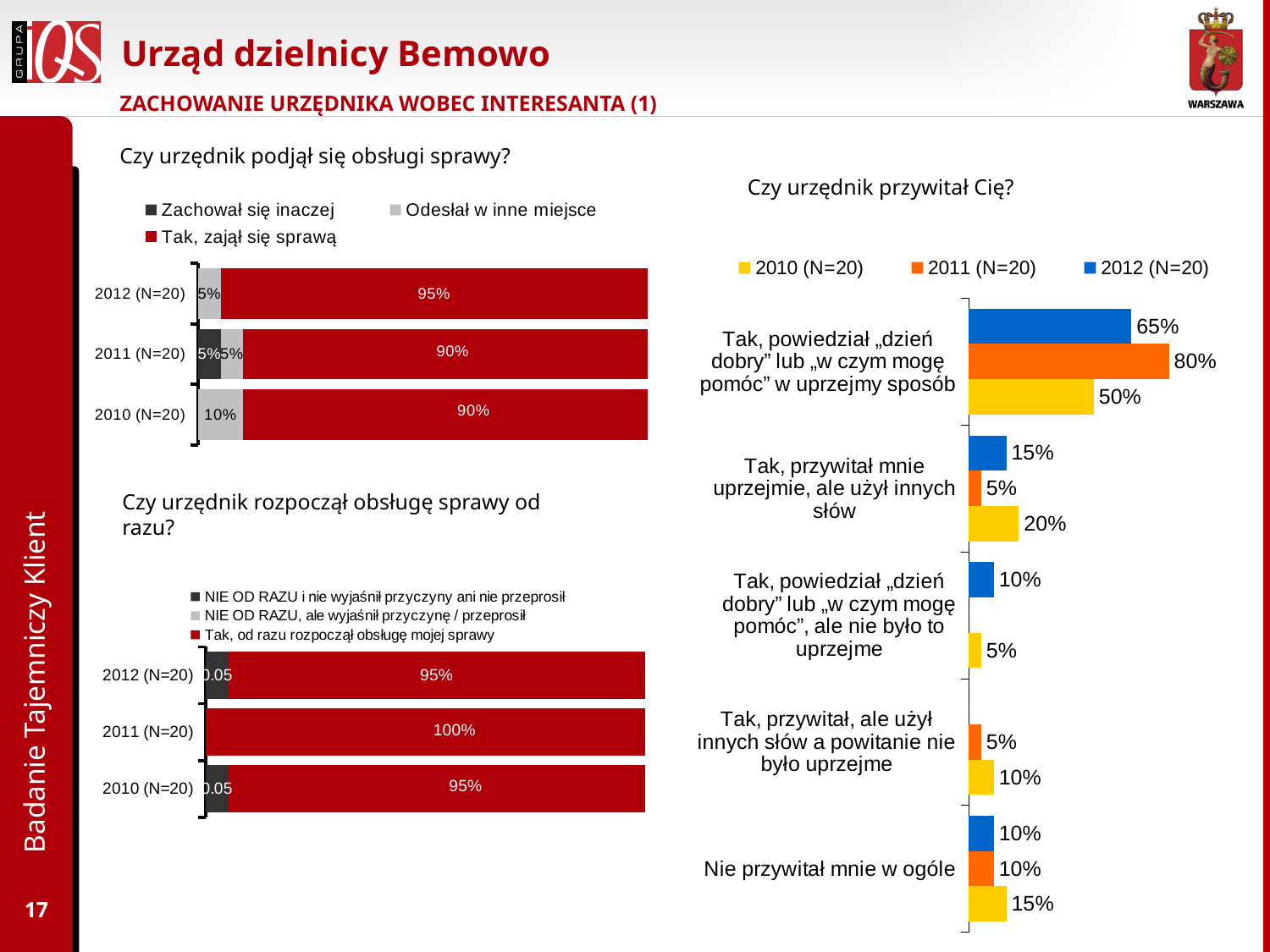
In the chart "Czy urzędnik przywitał Cię?", which year has the highest value for "Tak, powiedział „dzień dobry” lub „w czym mogę pomóc” w uprzejmy sposób"? 2011 (N=20) In the chart "Czy urzędnik podjął się obsługi sprawy?", what is the "Tak, zajął się sprawą" value for 2012 (N=20)? 95% In the chart "Czy urzędnik przywitał Cię?", how many series does the legend list? 3 In the chart "Czy urzędnik podjął się obsługi sprawy?", what is the "Odesłał w inne miejsce" value for 2010 (N=20)? 10% In the chart "Czy urzędnik przywitał Cię?", what is the 2010 (N=20) value for "Nie przywitał mnie w ogóle"? 15% In the chart "Czy urzędnik przywitał Cię?", which is larger for "Tak, przywitał mnie uprzejmie, ale użył innych słów": the 2010 value or the 2012 value? 2010 (N=20) In the chart "Czy urzędnik przywitał Cię?", how many response categories are shown? 5 In the chart "Czy urzędnik podjął się obsługi sprawy?", which colour represents "Tak, zajął się sprawą"? Red In the chart "Czy urzędnik rozpoczął obsługę sprawy od razu?", what is the "Tak, od razu rozpoczął obsługę mojej sprawy" value for 2011 (N=20)? 100% In the chart "Czy urzędnik przywitał Cię?", what is the difference between the 2011 and 2010 values for "Tak, powiedział „dzień dobry” lub „w czym mogę pomóc” w uprzejmy sposób"? 30% In the chart "Czy urzędnik przywitał Cię?", what is the 2011 (N=20) value for "Tak, powiedział „dzień dobry” lub „w czym mogę pomóc” w uprzejmy sposób"? 80% What type of chart is "Czy urzędnik rozpoczął obsługę sprawy od razu?"? Stacked bar chart